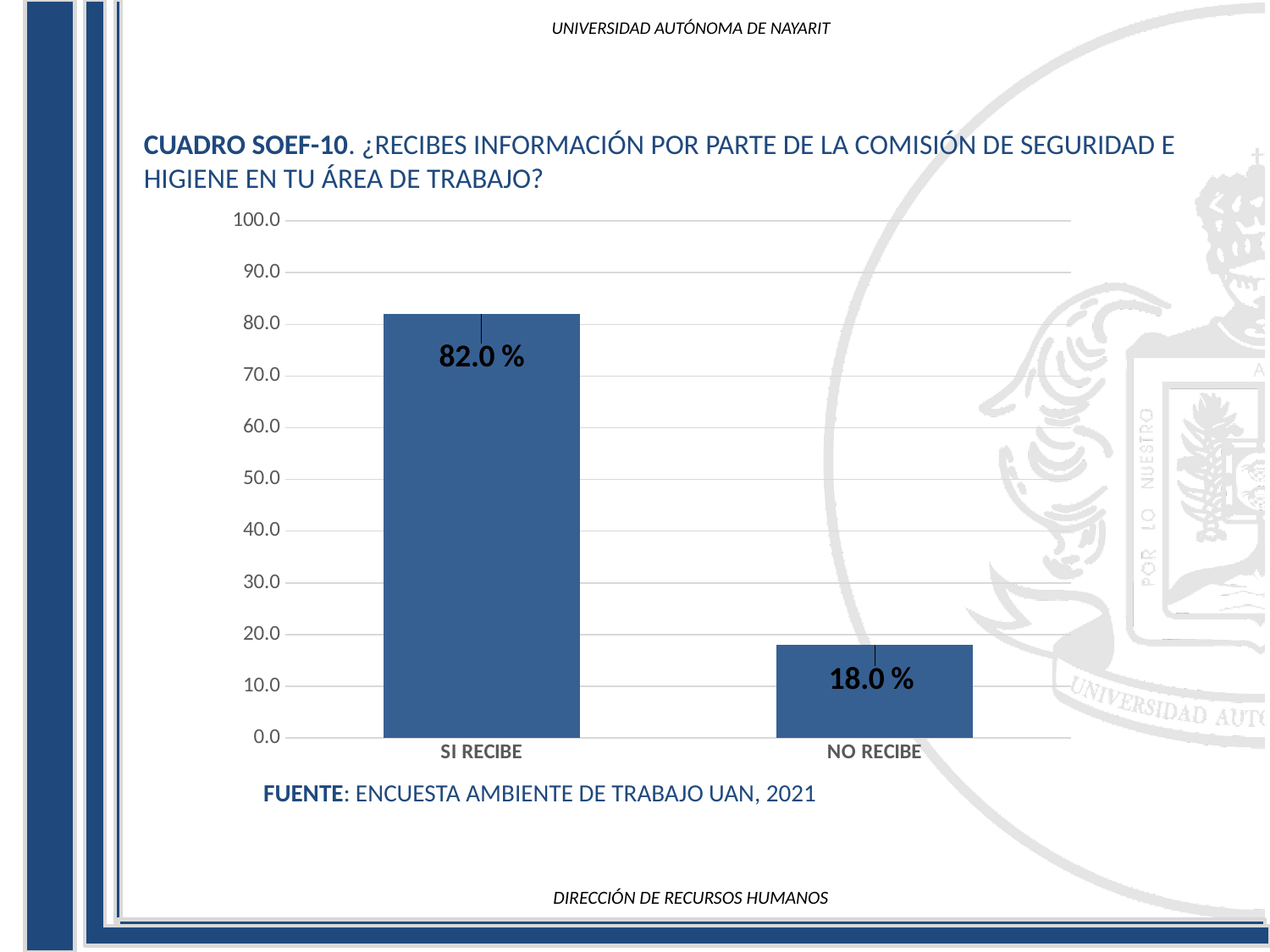
Is the value for SI RECIBE greater or less than 80.0? greater Which category has the lowest value? NO RECIBE Which category has the highest value? SI RECIBE Which is larger, the value for SI RECIBE or the value for NO RECIBE? SI RECIBE What is the maximum value shown on the y axis? 100.0 Is the value for NO RECIBE greater or less than 20.0? less What kind of chart is shown on the slide? Bar chart What is the difference between the values for SI RECIBE and NO RECIBE? 64.0 % What is the value for NO RECIBE? 18.0 % How many categories are shown on the x axis? 2 What is the source cited below the chart? ENCUESTA AMBIENTE DE TRABAJO UAN, 2021 What is the value for SI RECIBE? 82.0 %